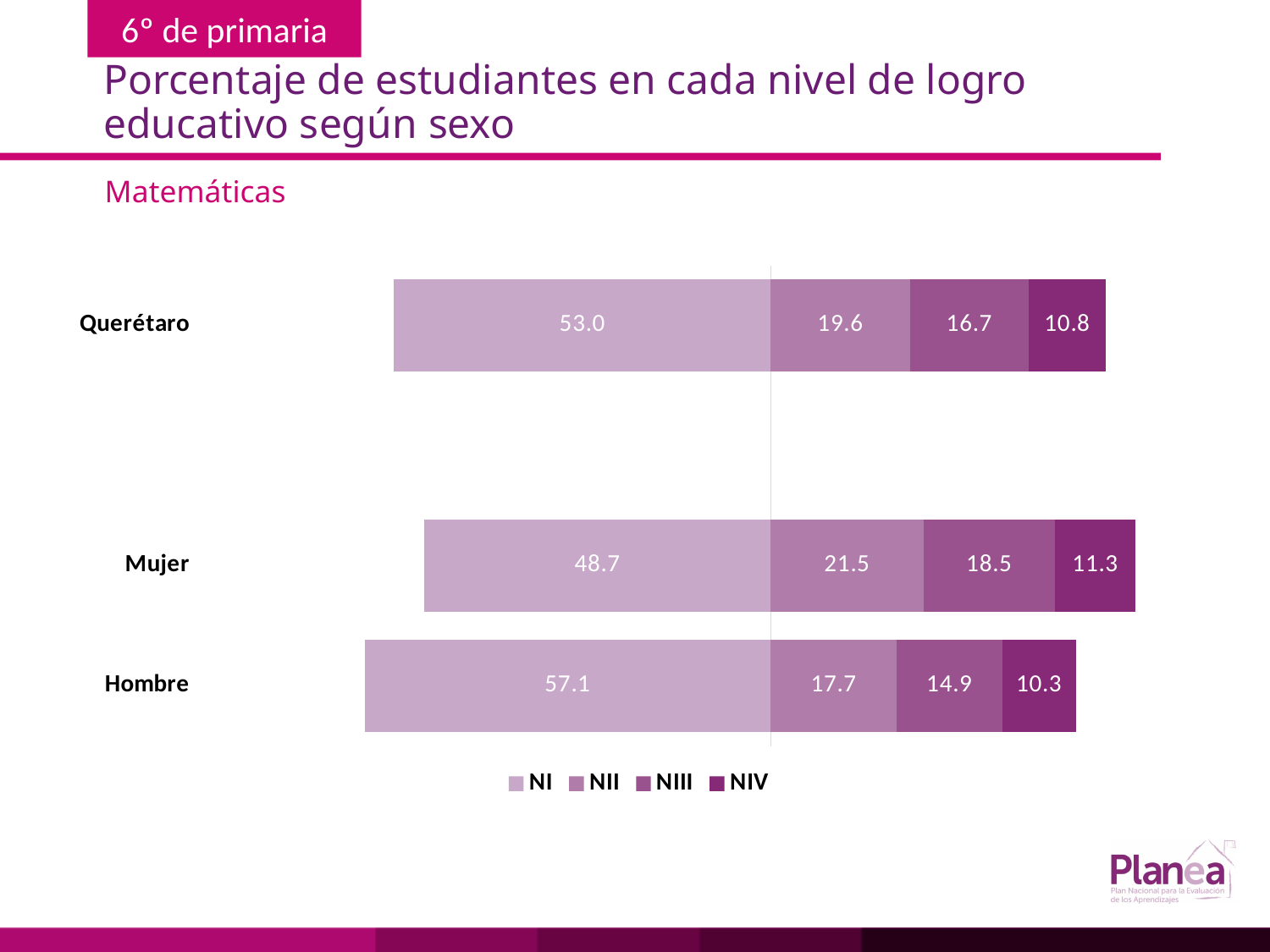
Which category has the highest NI value? Hombre How many series does the legend list? 4 Which category has the lowest NIII value? Hombre What is the NII value for Hombre? 17.7 What kind of chart is shown on the slide? stacked bar chart What is the difference between the NI values for Hombre and Mujer? 8.4 What subject is named above the chart? Matemáticas What is the NI value for Querétaro? 53.0 How many categories are shown on the chart? 3 Which is larger, the NII value for Mujer or the NII value for Querétaro? Mujer What is the total of the stacked bar for Hombre? 100.0 What is the NIV value for Mujer? 11.3